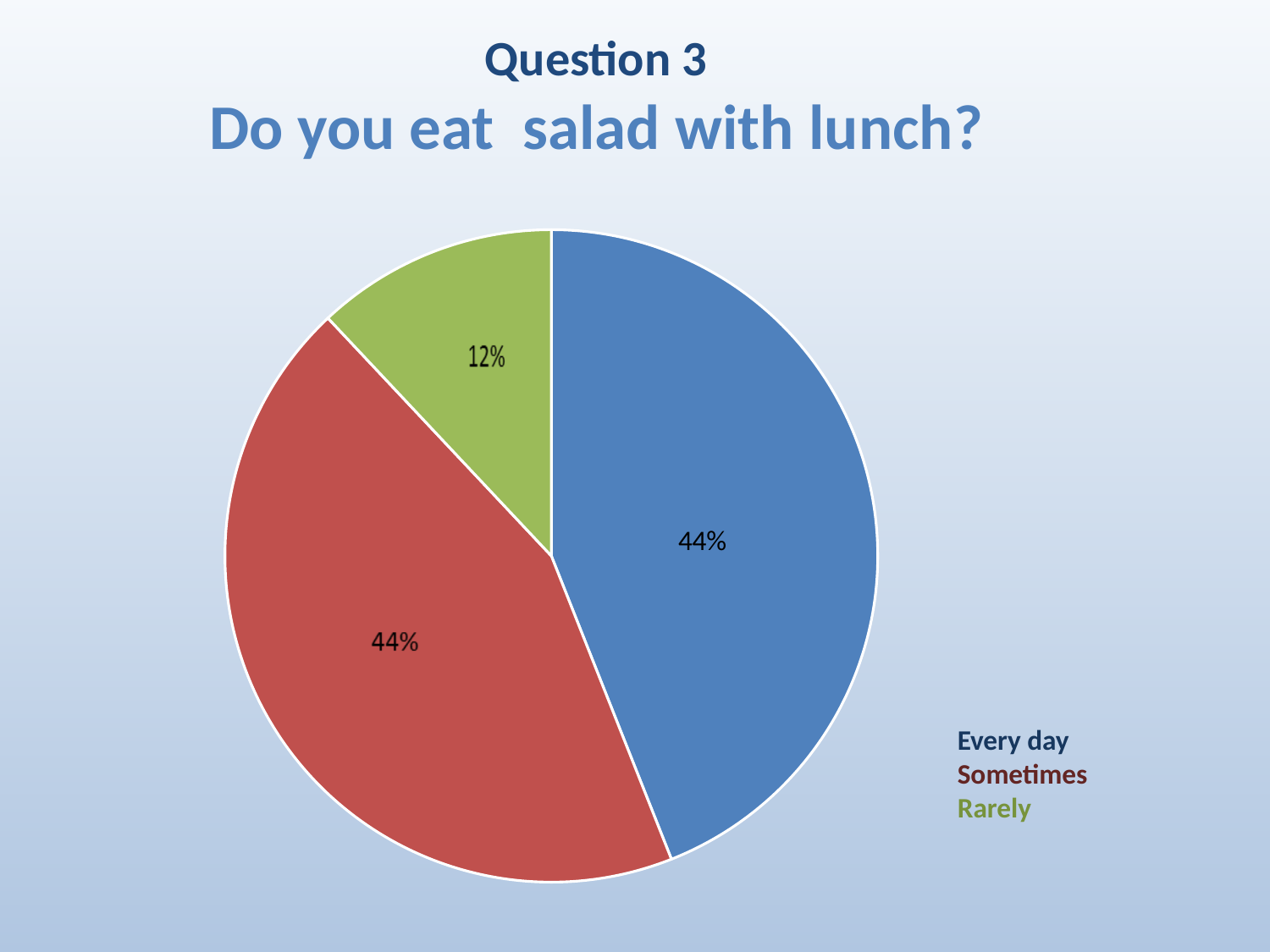
Which colour represents the 'Rarely' response in the pie chart? green What is the difference in percentage points between the 'Sometimes' and 'Rarely' shares? 32 How many entries does the legend list? 3 What kind of chart is shown on the slide? pie chart What question does the chart title ask? Do you eat salad with lunch? Is the share for 'Every day' larger or smaller than the share for 'Rarely'? larger What percentage of respondents answered 'Sometimes'? 44% How many slices does the pie chart have? 3 What percentage of respondents answered 'Rarely'? 12% What percentage of respondents eat salad with lunch every day? 44% Which response has the smallest share of the pie? Rarely Is the share for 'Rarely' greater or less than 20%? less